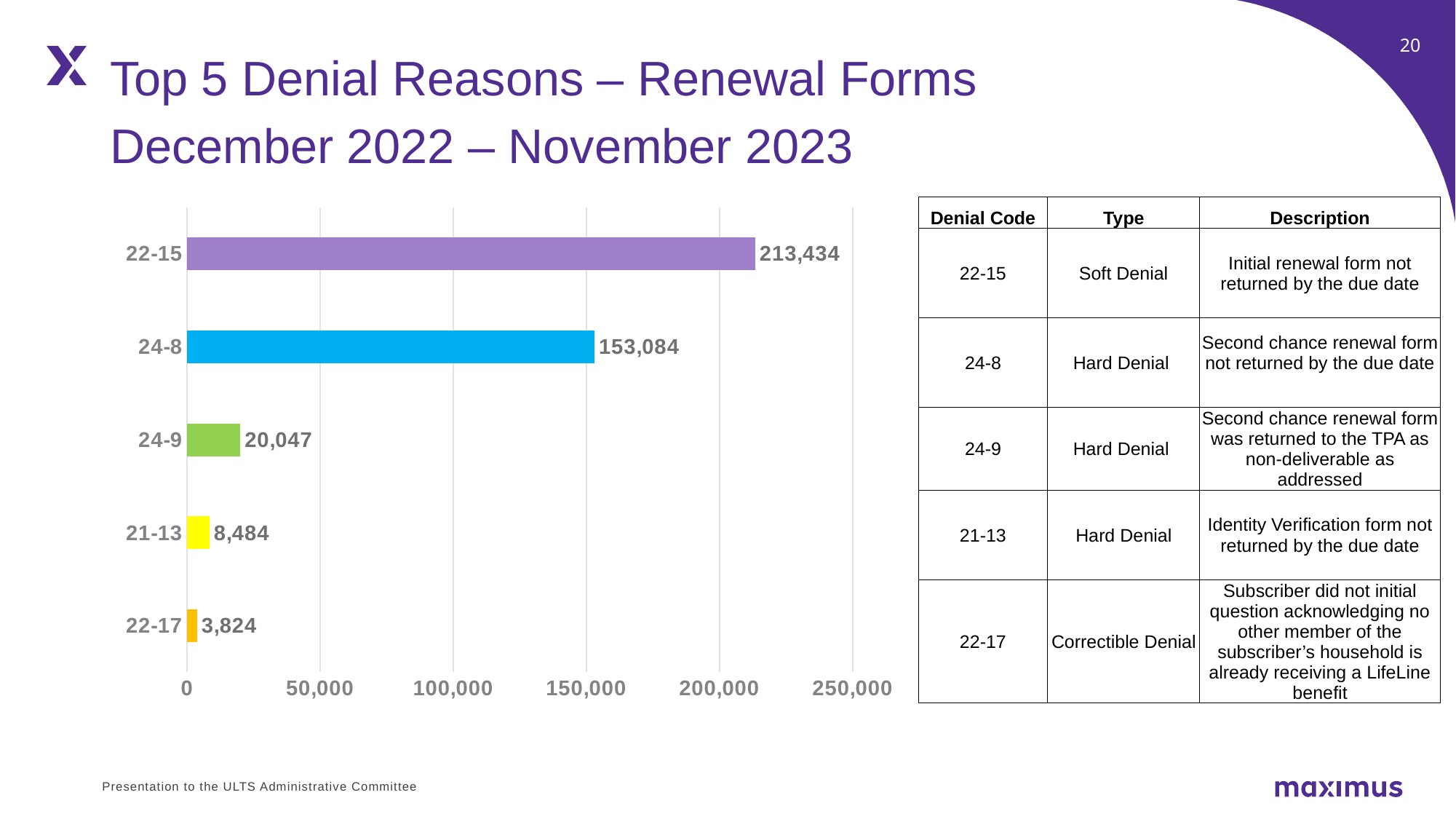
What is the value for denial code 22-15? 213,434 What is the difference between the values for 21-13 and 22-17? 4,660 Is the value for 24-8 greater or less than 150,000? greater Which denial code has the lowest value? 22-17 Which is larger, the value for 24-9 or the value for 21-13? 24-9 What is the difference between the values for 22-15 and 24-8? 60,350 What is the value for denial code 24-8? 153,084 What is the value for denial code 22-17? 3,824 What kind of chart is shown on the slide? Bar chart How many denial codes are shown in the chart? 5 Which denial code has the highest value? 22-15 What is the value for denial code 24-9? 20,047